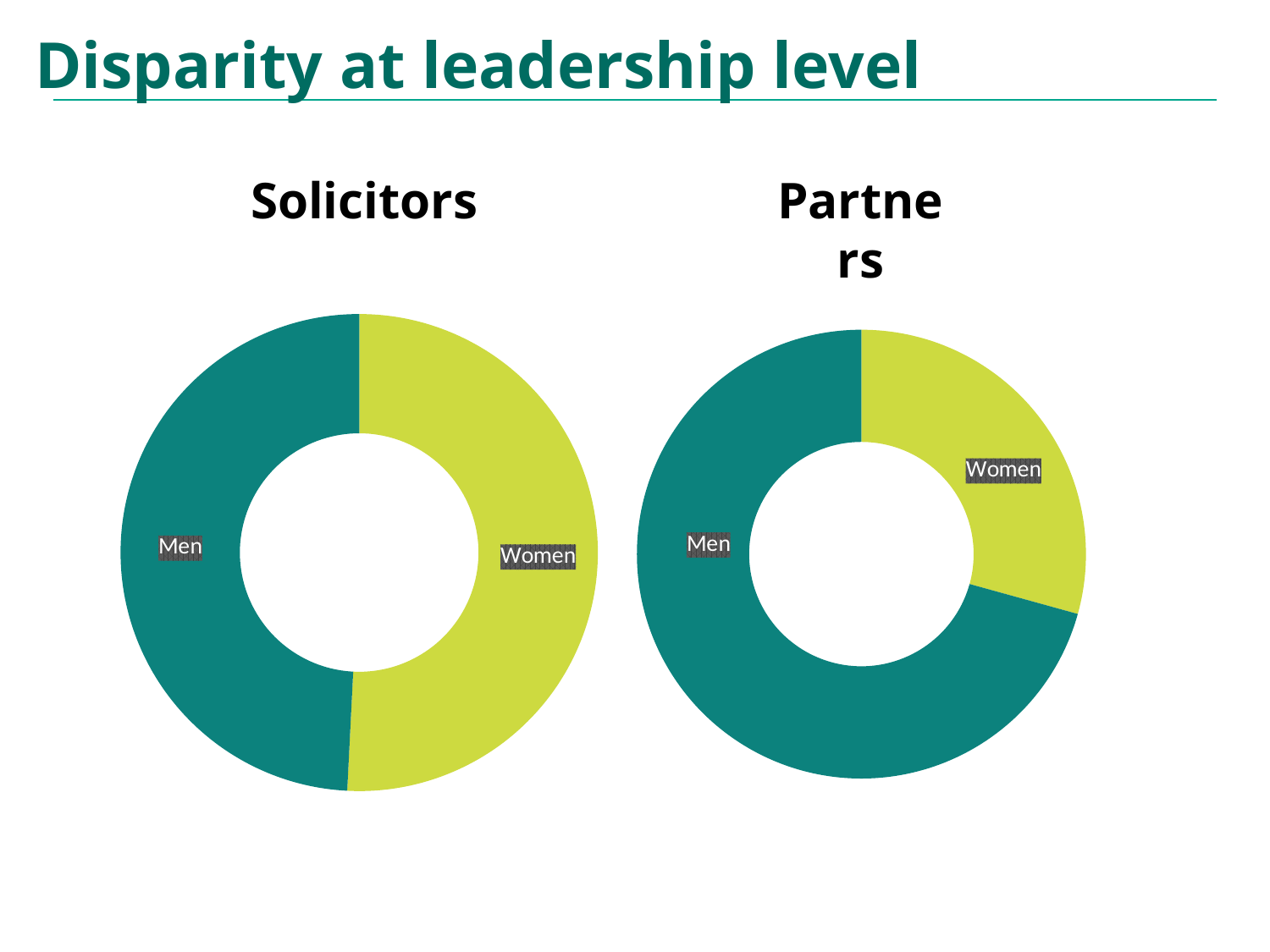
What kind of chart is the Partners chart? Doughnut chart In the Partners chart, which category has the larger share, Men or Women? Men What kind of chart is the Solicitors chart? Doughnut chart How many categories does the Solicitors chart show? 2 In the Partners chart, which category has the largest share? Men How many charts are shown on the slide? 2 How many categories does the Partners chart show? 2 In the Partners chart, which category has the smallest share? Women Which chart shows a larger share for Women, Solicitors or Partners? Solicitors What are the two categories labelled on the Solicitors chart? Men and Women What is the title of the chart on the left of the slide? Solicitors